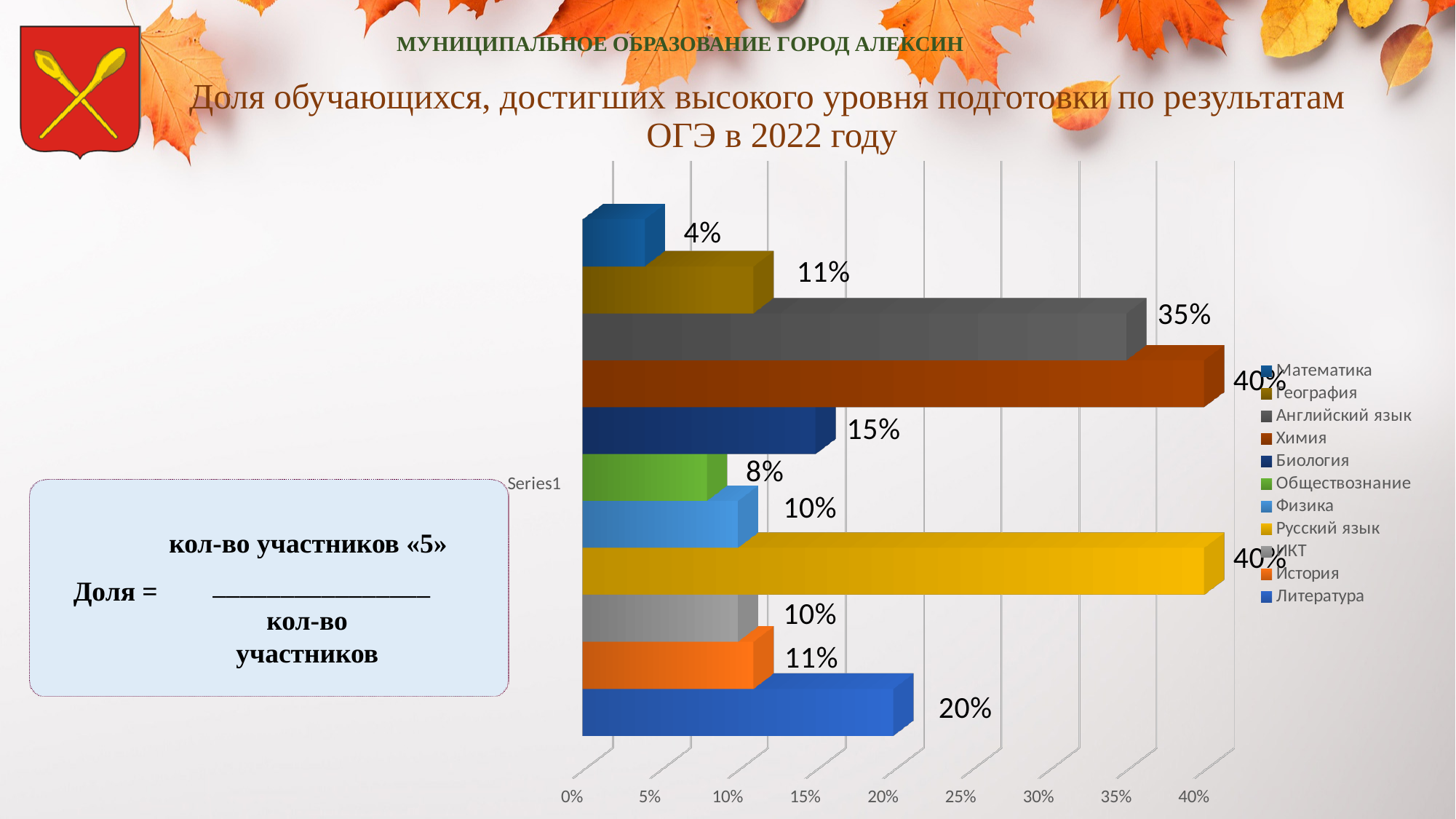
What kind of chart is shown on the slide? Bar chart What is the value for Математика? 4% Which is larger, the value for География or the value for Биология? Биология Which subject has the lowest value? Математика What is the difference between the values for Химия and Английский язык? 5% What is the value for Биология? 15% How many series does the legend list? 11 What is the value for Обществознание? 8% Which two subjects both have a value of 40%? Химия and Русский язык What is the value for Литература? 20% What is the value for Английский язык? 35% What is the difference between the values for Литература and Физика? 10%